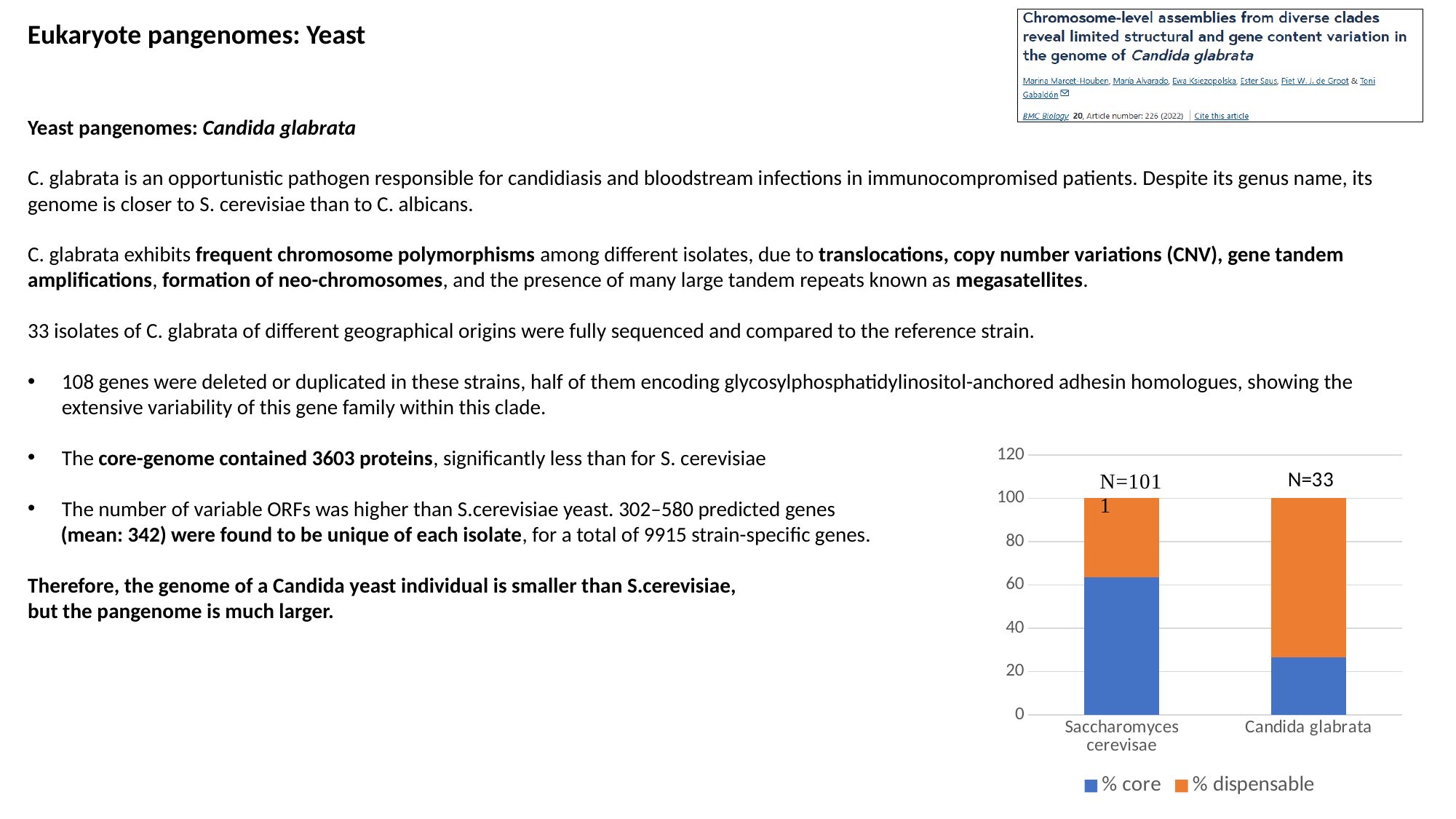
What kind of chart is shown on the slide? Stacked bar chart Which category has the larger % dispensable value, Saccharomyces cerevisae or Candida glabrata? Candida glabrata Which colour represents the % dispensable series in the chart? Orange What N value is written above the Candida glabrata bar? N=33 Is the % core value for Saccharomyces cerevisae greater or less than 40? greater How many categories are shown on the x axis of the chart? 2 Which category has the lower % core value? Candida glabrata What is the total height of the stacked bar for Saccharomyces cerevisae? 100 How many series does the chart legend list? 2 What is the total height of the stacked bar for Candida glabrata? 100 Is the % core value for Candida glabrata greater or less than 40? less Which category has the higher % core value? Saccharomyces cerevisae